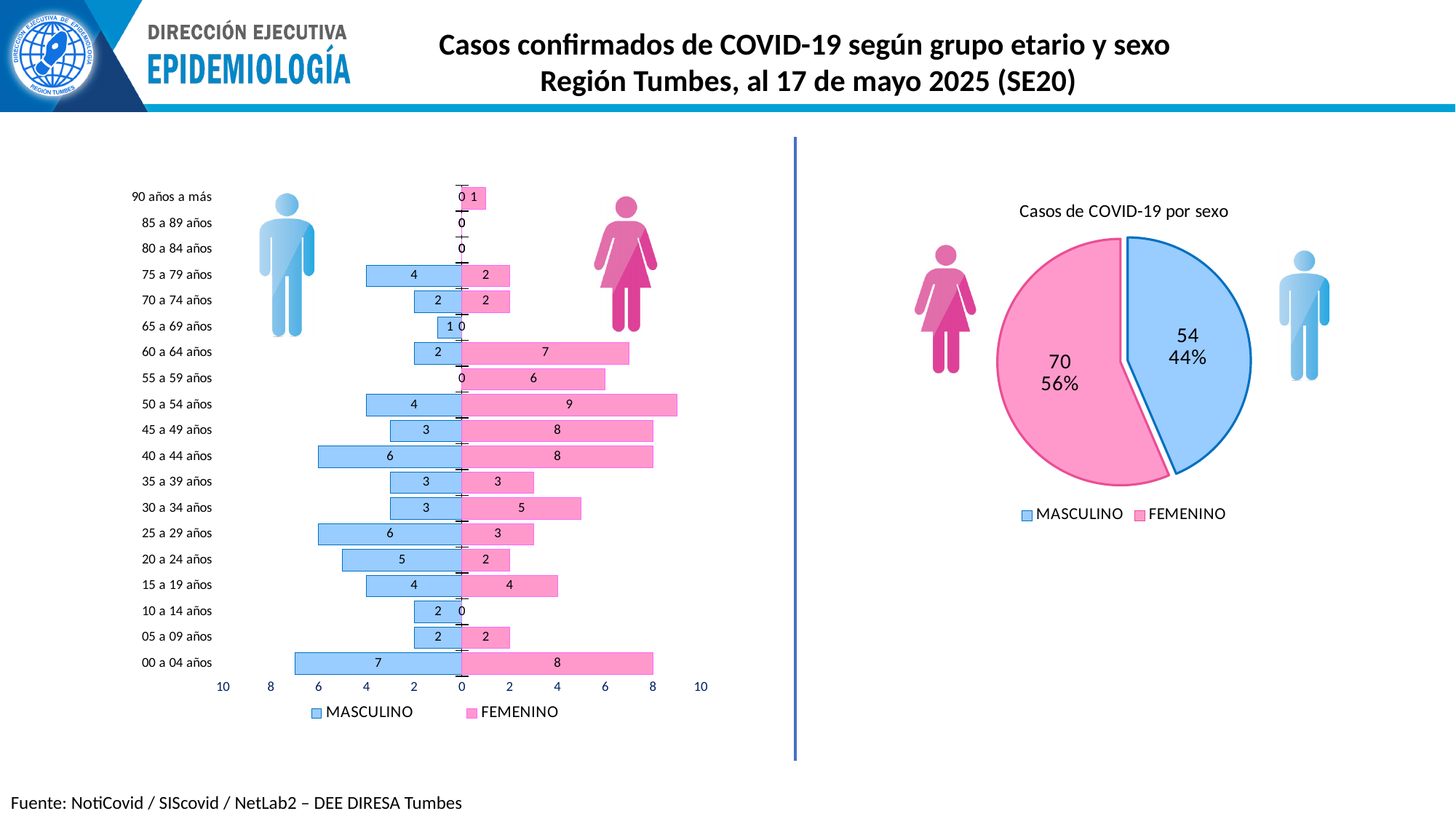
In the left bar chart, which age group has the highest FEMENINO value? 50 a 54 años In the left bar chart, how many FEMENINO cases are in the 50 a 54 años group? 9 In the pie chart 'Casos de COVID-19 por sexo', what is the total number of cases across both slices? 124 In the left bar chart, what is the difference between the FEMENINO and MASCULINO values for the 60 a 64 años group? 5 In the pie chart 'Casos de COVID-19 por sexo', what share of cases is MASCULINO? 44% In the left bar chart, how many age groups are shown on the vertical axis? 19 In the pie chart 'Casos de COVID-19 por sexo', how many cases are FEMENINO? 70 In the left bar chart, how many MASCULINO cases are in the 00 a 04 años group? 7 What kind of chart is the chart on the left side of the slide? Bar chart What is the title of the pie chart on the right side of the slide? Casos de COVID-19 por sexo How many series does the legend of the left chart list? 2 In the left bar chart, which is larger for the 25 a 29 años group, MASCULINO or FEMENINO? MASCULINO